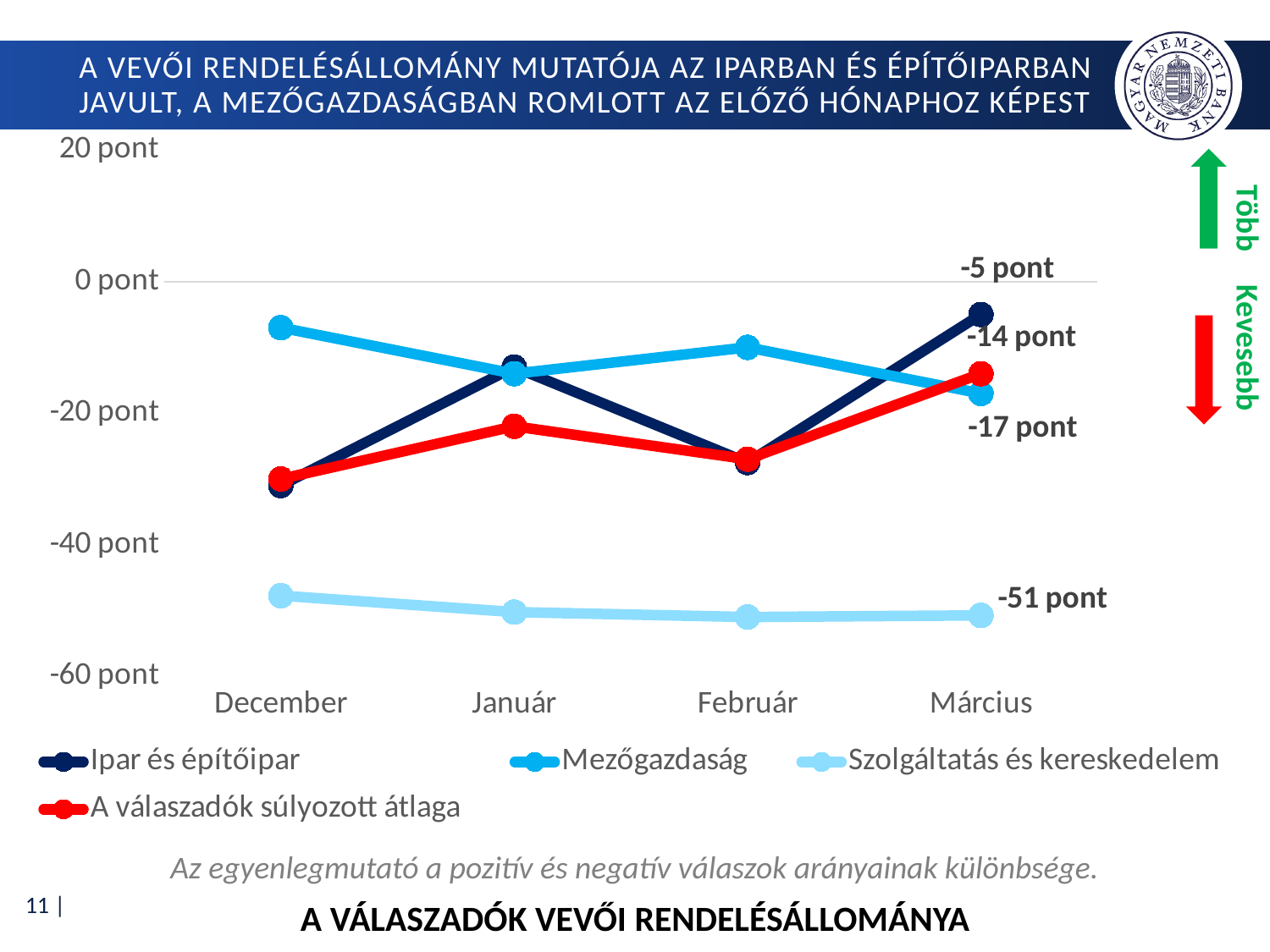
How many series does the legend list? 4 What is the value for Szolgáltatás és kereskedelem in Március? -51 pont Which series has the lowest value in Március? Szolgáltatás és kereskedelem In December, which is larger: Mezőgazdaság or Ipar és építőipar? Mezőgazdaság How many months are shown on the x axis? 4 What is the value for A válaszadók súlyozott átlaga in Március? -14 pont What kind of chart is shown on the slide? line chart What is the value for Mezőgazdaság in Március? -17 pont What is the difference between Ipar és építőipar and Szolgáltatás és kereskedelem in Március? 46 pont Which series has the highest value in Március? Ipar és építőipar What is the value for Ipar és építőipar in Március? -5 pont Is the value for Szolgáltatás és kereskedelem in December greater or less than -40 pont? less